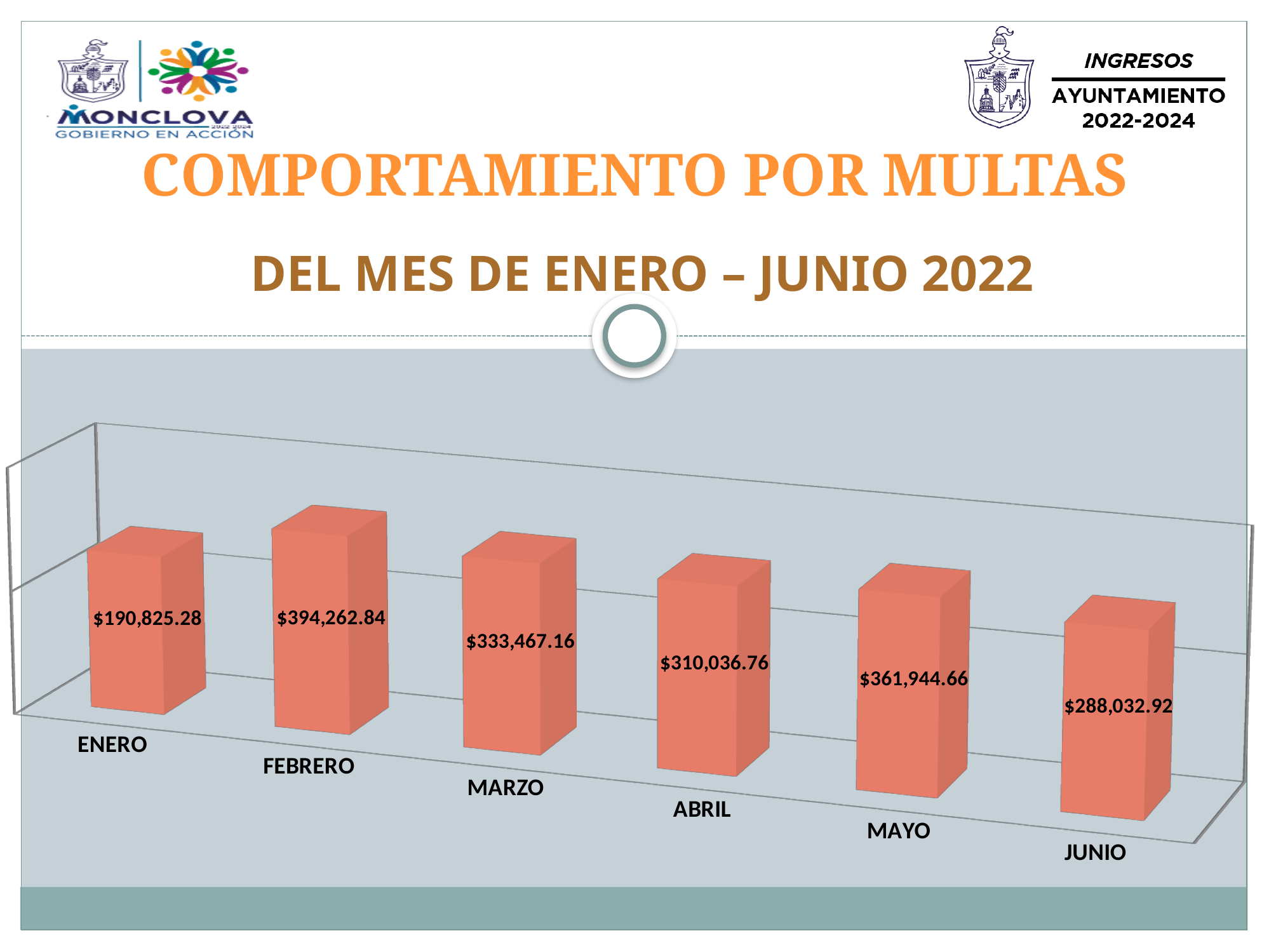
Which month has the highest value? FEBRERO What is the value for FEBRERO? $394,262.84 What kind of chart is shown on the slide? Bar chart What is the value for ABRIL? $310,036.76 Does the value rise or fall from MAYO to JUNIO? Fall What is the value for JUNIO? $288,032.92 What is the difference between the values for FEBRERO and ENERO? $203,437.56 Which is larger, the value for MAYO or the value for ABRIL? MAYO Which is larger, the value for MARZO or the value for JUNIO? MARZO Which month has the lowest value? ENERO How many months are shown in the chart? 6 What is the difference between the values for MAYO and ABRIL? $51,907.90